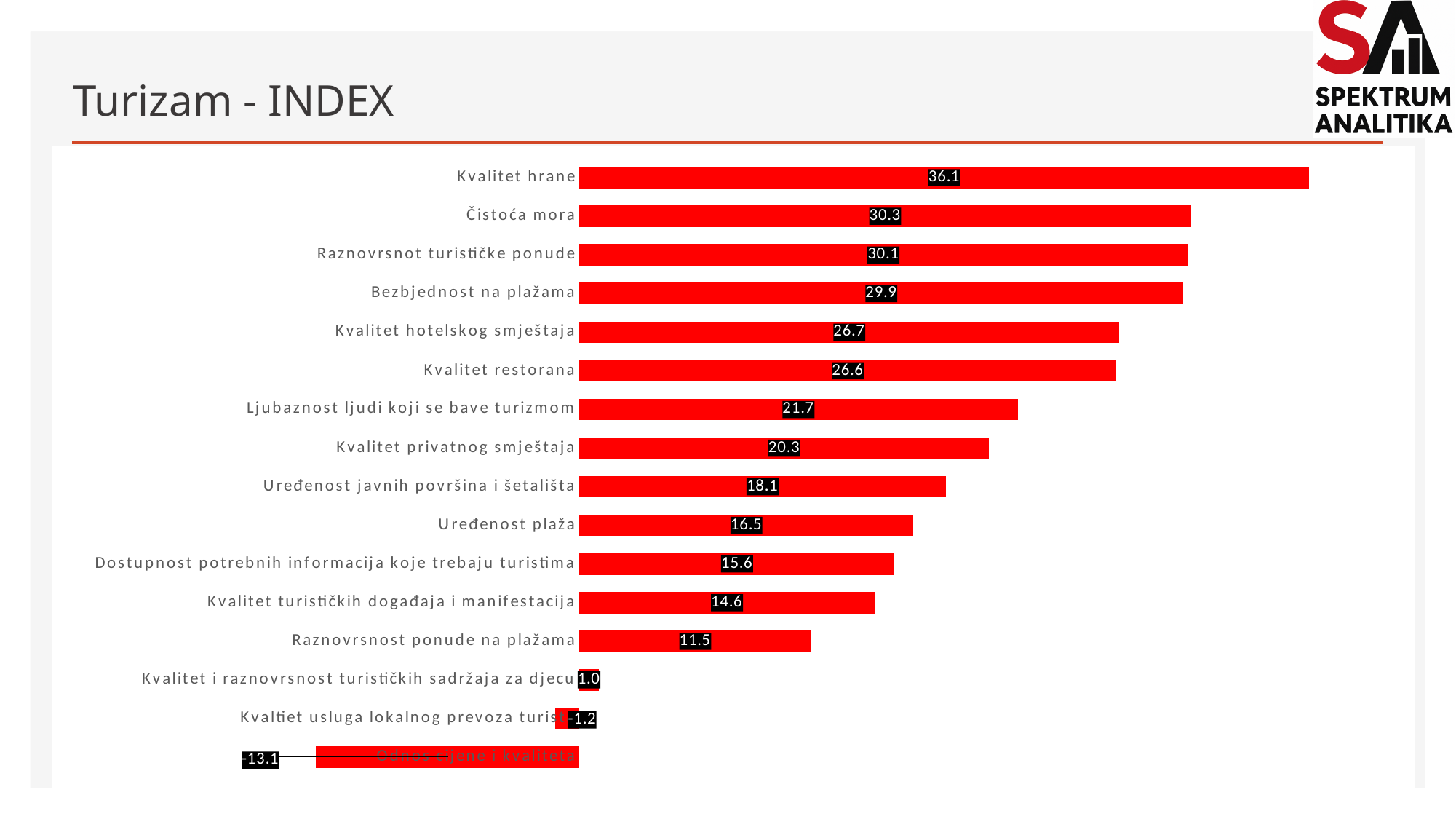
What is the value for Kvalitet hrane? 36.1 What is the value for Raznovrsnost ponude na plažama? 11.5 Which is larger, the value for Kvalitet hrane or the value for Uređenost plaža? Kvalitet hrane What is the difference between the values for Kvalitet hrane and Čistoća mora? 5.8 What is the value for Čistoća mora? 30.3 Which category has the highest value? Kvalitet hrane What is the value for Kvalitet privatnog smještaja? 20.3 What is the value for Kvalitet i raznovrsnost turističkih sadržaja za djecu? 1.0 What is the difference between the values for Ljubaznost ljudi koji se bave turizmom and Kvalitet privatnog smještaja? 1.4 What kind of chart is shown on the slide? Bar chart How many categories are shown in the chart? 16 What is the title of the slide? Turizam - INDEX